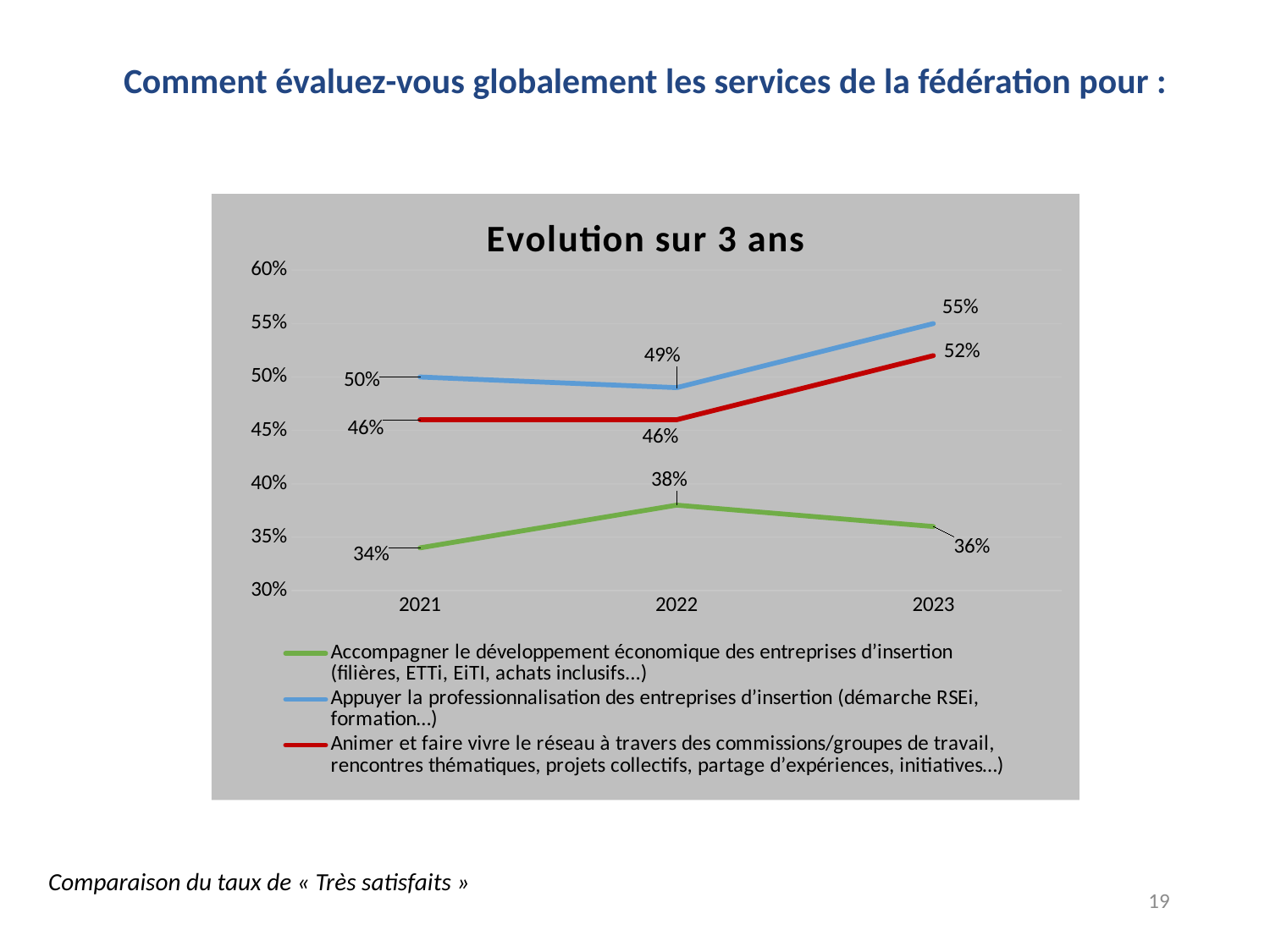
In which year is the value for 'Appuyer la professionnalisation des entreprises d'insertion' the highest? 2023 How many years are shown on the x axis? 3 Does the value for 'Animer et faire vivre le réseau' rise or fall between 2022 and 2023? Rise What type of chart is shown on the slide? Line chart How many series does the legend list? 3 What is the title of the chart? Evolution sur 3 ans What is the value for 'Appuyer la professionnalisation des entreprises d'insertion' in 2023? 55% What is the value for 'Accompagner le développement économique des entreprises d'insertion' in 2022? 38% In which year is the value for 'Accompagner le développement économique des entreprises d'insertion' the lowest? 2021 What is the value for 'Animer et faire vivre le réseau' in 2021? 46% What is the difference between the 2023 and 2022 values for 'Animer et faire vivre le réseau'? 6% Which series has the higher value in 2022: 'Appuyer la professionnalisation' or 'Animer et faire vivre le réseau'? Appuyer la professionnalisation des entreprises d'insertion